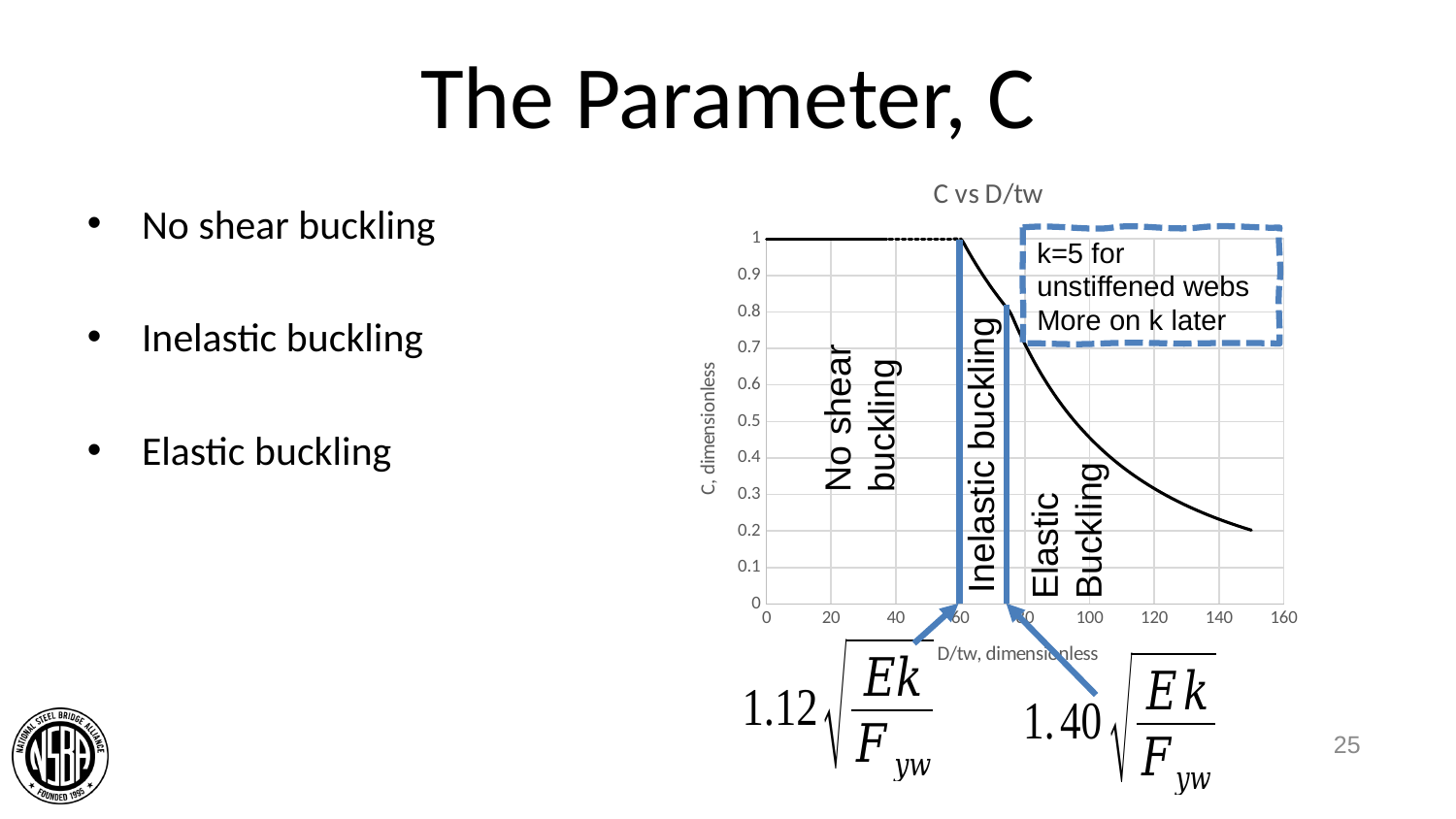
What is the highest value shown on the x axis of the chart? 160 Is the value of C at D/tw = 120 greater or less than 0.4? less Is the value of C at D/tw = 100 greater or less than 0.5? less What kind of chart is shown on the slide? line chart What is the title of the chart? C vs D/tw Which is larger, the value of C at D/tw = 80 or at D/tw = 120? D/tw = 80 Is the value of C at D/tw = 80 greater or less than 0.5? greater What is the label of the x axis of the chart? D/tw, dimensionless Does the value of C rise or fall as D/tw increases beyond about 60? fall